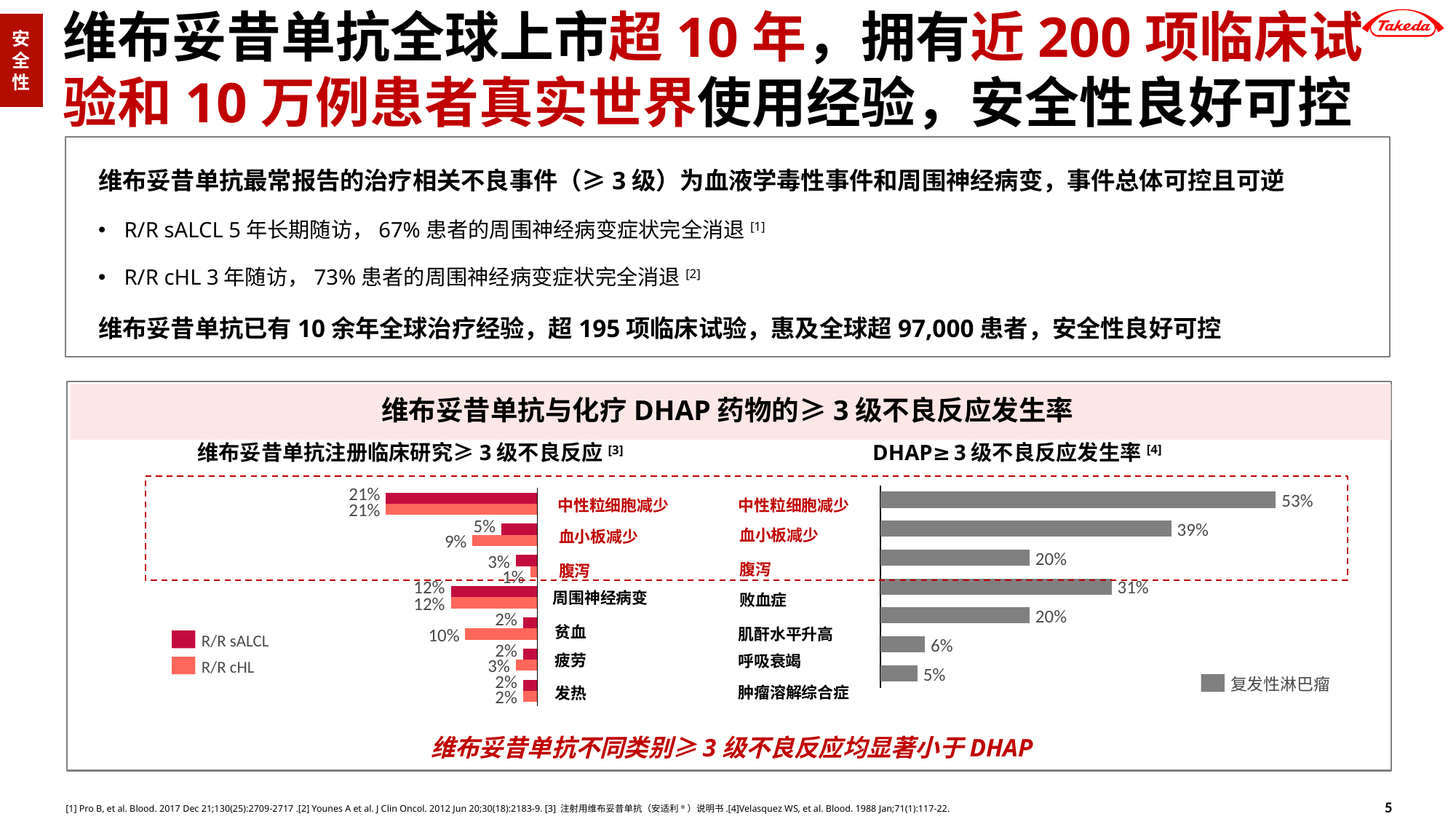
In the DHAP≥3级不良反应发生率 chart, how many categories are shown? 7 In the DHAP≥3级不良反应发生率 chart, which category has the lowest value? 肿瘤溶解综合症 What kind of chart is the DHAP≥3级不良反应发生率 chart? Bar chart In the DHAP≥3级不良反应发生率 chart, what is the value for 中性粒细胞减少? 53% In the DHAP≥3级不良反应发生率 chart, which category has the highest value? 中性粒细胞减少 In the DHAP≥3级不良反应发生率 chart, what is the difference between 中性粒细胞减少 and 血小板减少? 14% In the 维布妥昔单抗注册临床研究≥3级不良反应 chart, which is larger for 腹泻: R/R sALCL or R/R cHL? R/R sALCL In the 维布妥昔单抗注册临床研究≥3级不良反应 chart, how many series does the legend list? 2 In the 维布妥昔单抗注册临床研究≥3级不良反应 chart, what is the R/R cHL value for 贫血? 10% In the DHAP≥3级不良反应发生率 chart, what is the value for 败血症? 31% In the 维布妥昔单抗注册临床研究≥3级不良反应 chart, what is the difference between the R/R cHL and R/R sALCL values for 血小板减少? 4% In the 维布妥昔单抗注册临床研究≥3级不良反应 chart, what is the R/R sALCL value for 血小板减少? 5%